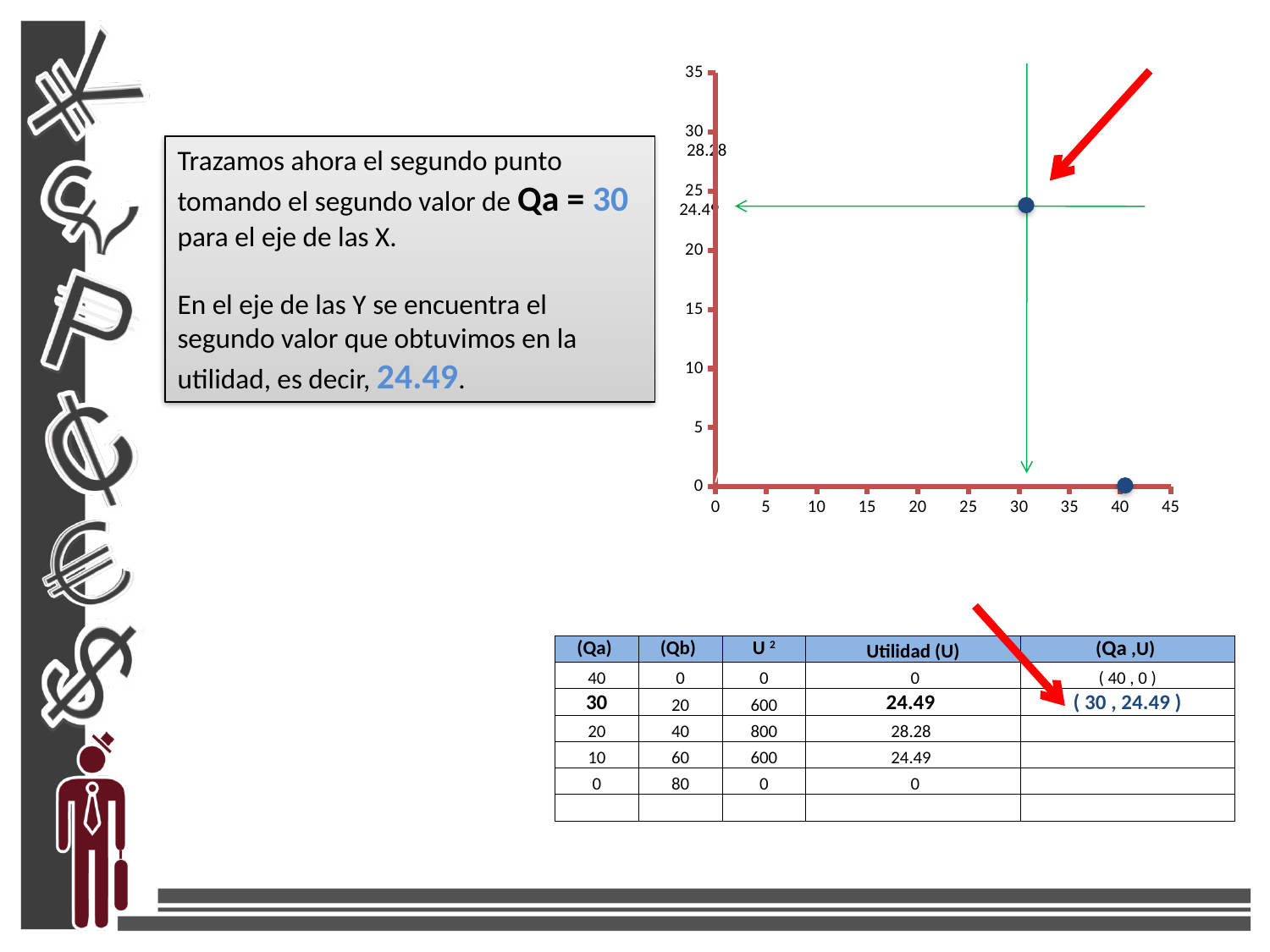
Do the y values rise or fall as x increases from 30 to 40? fall Is the y value of the point at x = 30 greater or less than 25? less Which plotted point has the lowest y value? the point at x = 40 How many data points are plotted on the chart? 2 What is the highest tick value shown on the y axis? 35 What is the y value of the point plotted at x = 30? 24.49 What kind of chart is shown on the slide? scatter chart What is the y value of the point plotted at x = 40? 0 Which plotted point has the higher y value, the one at x = 30 or the one at x = 40? the one at x = 30 Is the y value of the point at x = 30 greater or less than 20? greater What is the difference between the y values of the points at x = 30 and x = 40? 24.49 What is the highest tick value shown on the x axis? 45